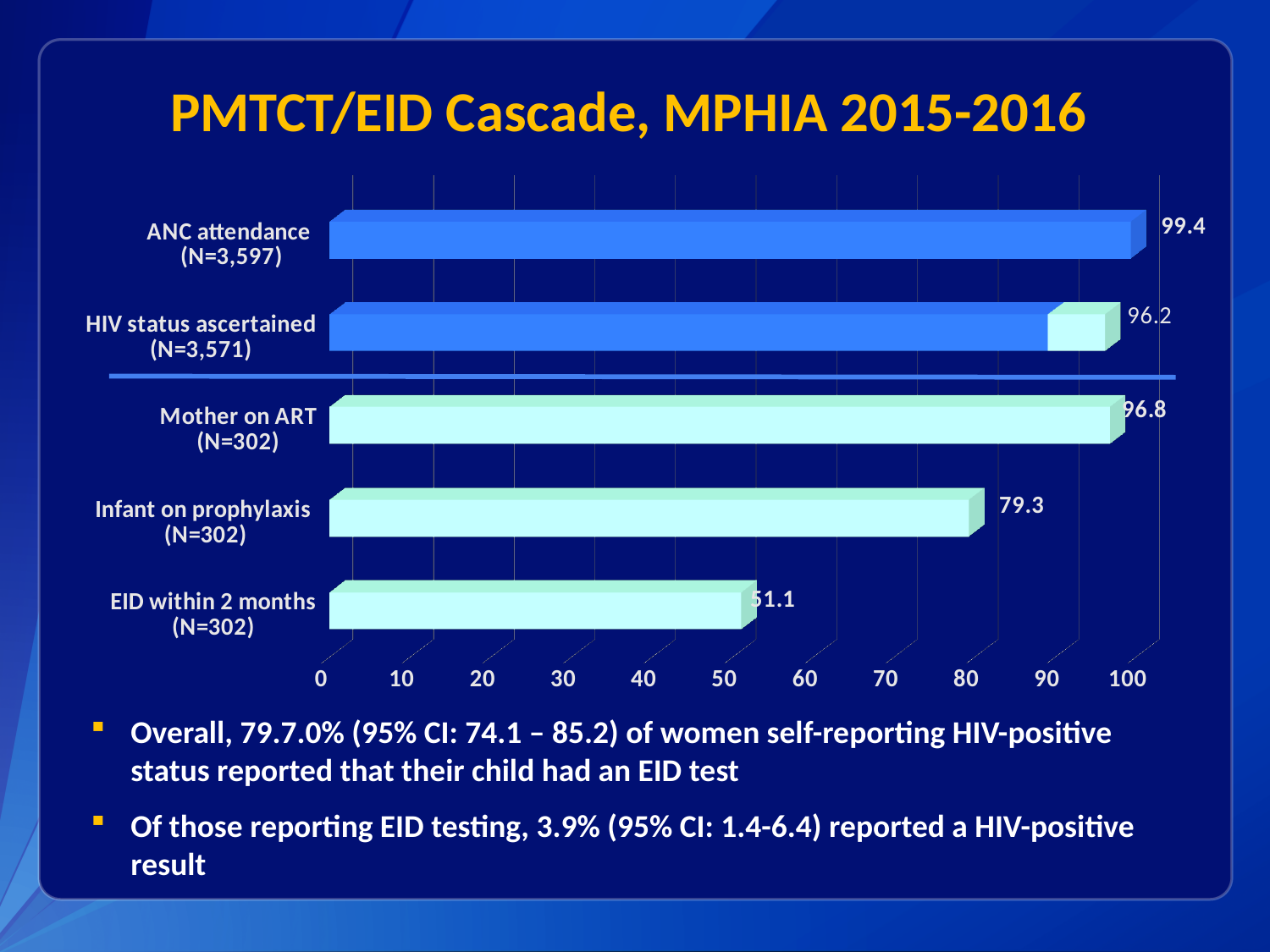
What is the difference between the values for Infant on prophylaxis and EID within 2 months? 28.2 What is the value for Infant on prophylaxis (N=302)? 79.3 What is the value for Mother on ART (N=302)? 96.8 Which category has the highest value? ANC attendance (N=3,597) What type of chart is shown on the slide? bar chart Which is larger, the value for Mother on ART or the value for Infant on prophylaxis? Mother on ART What is the value for EID within 2 months (N=302)? 51.1 What is the value for ANC attendance (N=3,597)? 99.4 How many categories are shown in the chart? 5 Is the value for EID within 2 months greater or less than 60? less Which category has the lowest value? EID within 2 months (N=302) What is the difference between the values for ANC attendance and HIV status ascertained? 3.2